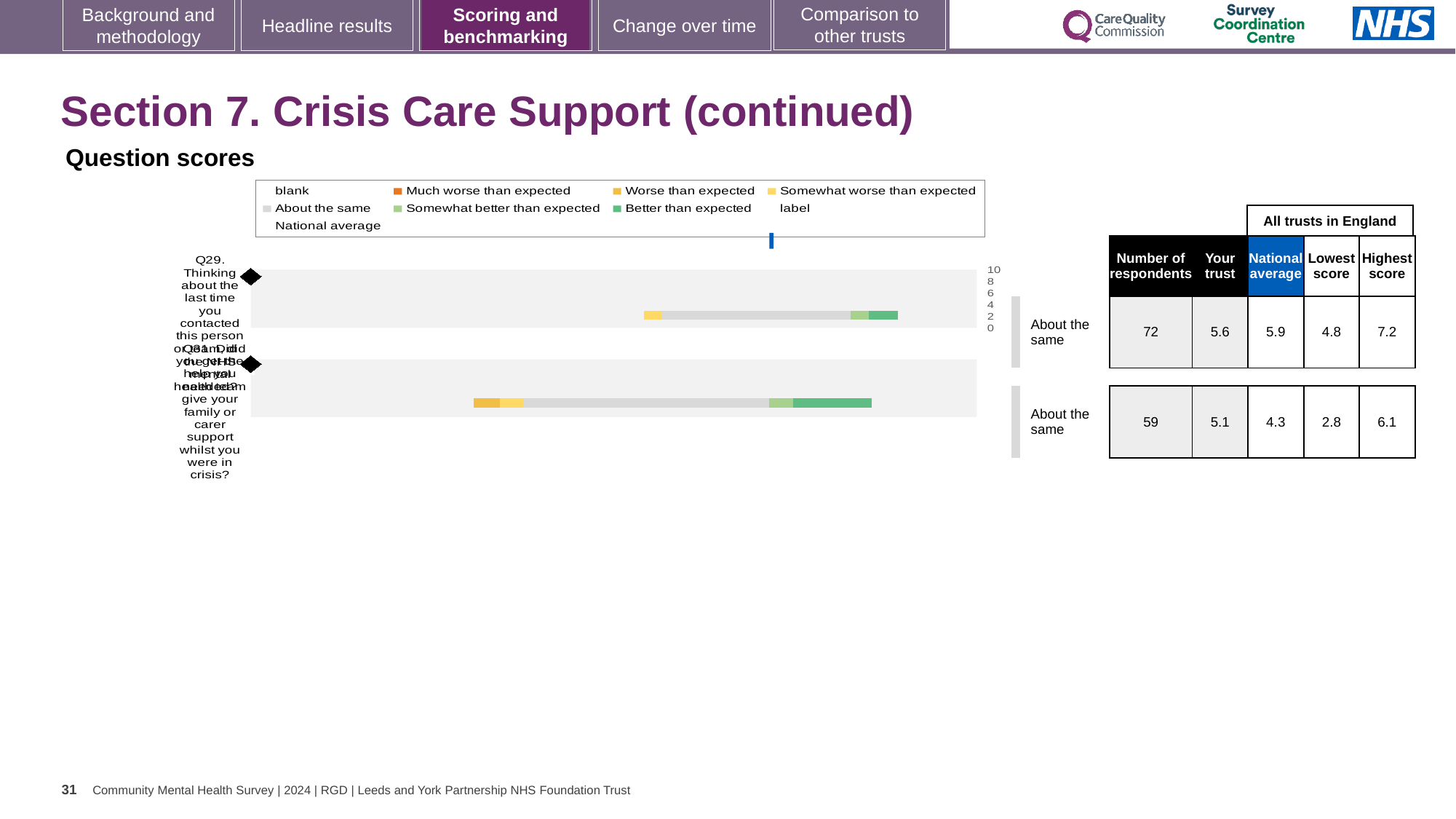
In the table next to the chart, what is the lowest score among all trusts in England for Q31? 2.8 In the chart legend, which colour represents 'Better than expected'? green In the table next to the chart, what is the number of respondents for Q29? 72 How many questions (bars) are plotted in the Question scores chart? 2 What benchmark category is shown for both Q29 and Q31 beside the chart? About the same In the table next to the chart, what is the 'Your trust' score for Q31? 5.1 In the table next to the chart, what is the highest score among all trusts in England for Q31? 6.1 In the table next to the chart, what is the national average for Q29? 5.9 In the table next to the chart, which question has the higher 'Your trust' score, Q29 or Q31? Q29 What kind of chart is shown under 'Question scores'? bar chart In the chart legend, which colour represents 'About the same'? grey In the table next to the chart, what is the difference between the highest and lowest score for Q29? 2.4